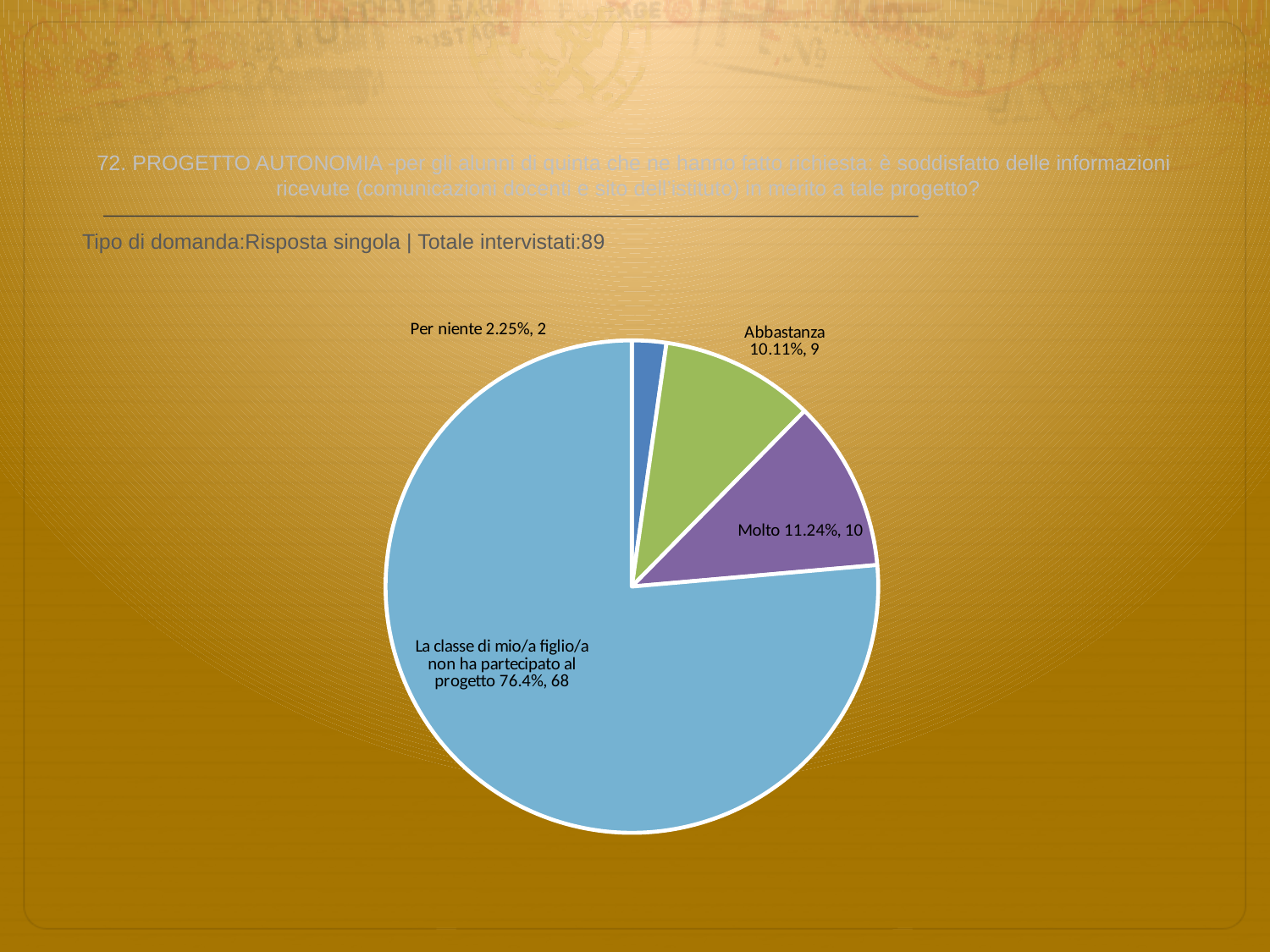
What percentage is shown for the "Molto" slice? 11.24% How many respondents are shown for the "Abbastanza" slice? 9 Which slice of the pie chart is the largest? La classe di mio/a figlio/a non ha partecipato al progetto How many slices does the pie chart have? 4 What share of the pie does the "La classe di mio/a figlio/a non ha partecipato al progetto" slice represent? 76.4% What kind of chart is shown on the slide? pie chart How many respondents are shown for the "La classe di mio/a figlio/a non ha partecipato al progetto" slice? 68 Which has more respondents, "Molto" or "Per niente"? Molto Which slice of the pie chart is the smallest? Per niente What is the difference in respondent count between "Molto" and "Abbastanza"? 1 What is the total number of respondents stated on the slide? 89 What percentage is shown for the "Per niente" slice? 2.25%